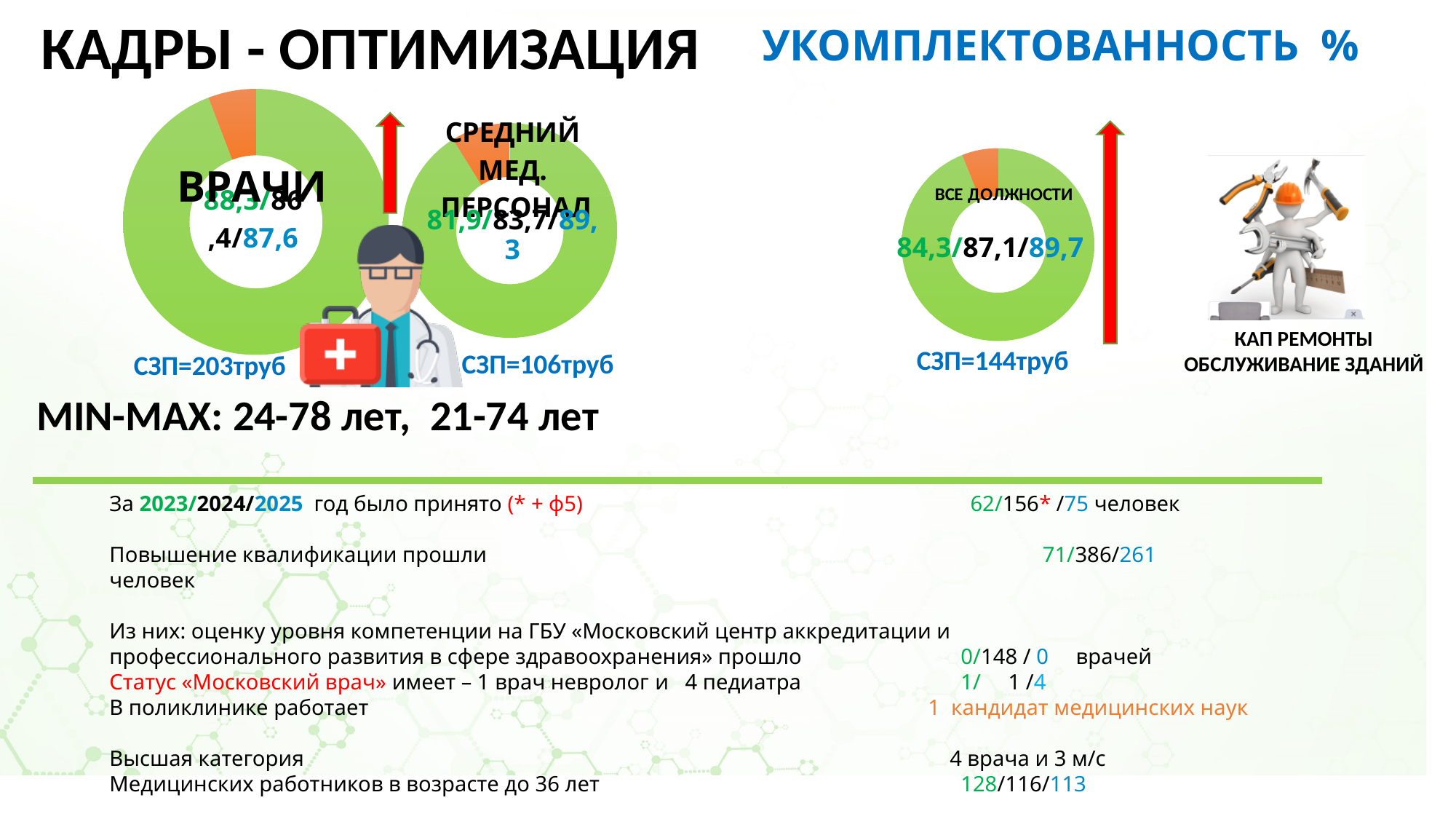
In the СРЕДНИЙ МЕД. ПЕРСОНАЛ chart, do the three values printed in the centre rise or fall from the first to the last? rise In the ВСЕ ДОЛЖНОСТИ chart, what is the last (blue) value printed in the centre? 89,7 In the ВСЕ ДОЛЖНОСТИ chart, what is the difference between the blue value (89,7) and the green value (84,3)? 5,4 In the ВРАЧИ chart, what is the last (blue) value printed in the centre? 87,6 In the ВСЕ ДОЛЖНОСТИ chart, what is the first (green) value printed in the centre? 84,3 In the СРЕДНИЙ МЕД. ПЕРСОНАЛ chart, what is the difference between the blue value (89,3) and the green value (81,9)? 7,4 How many donut (pie) charts are shown on the slide? 3 In the ВСЕ ДОЛЖНОСТИ chart, which is larger: the green value or the blue value? the blue value (89,7) Comparing the blue values, which chart shows the larger figure: ВРАЧИ or СРЕДНИЙ МЕД. ПЕРСОНАЛ? СРЕДНИЙ МЕД. ПЕРСОНАЛ What kind of chart is used for ВРАЧИ, СРЕДНИЙ МЕД. ПЕРСОНАЛ and ВСЕ ДОЛЖНОСТИ? doughnut chart What СЗП value is printed under the ВРАЧИ chart? СЗП=203труб In the СРЕДНИЙ МЕД. ПЕРСОНАЛ chart, what is the middle (black) value printed in the centre? 83,7